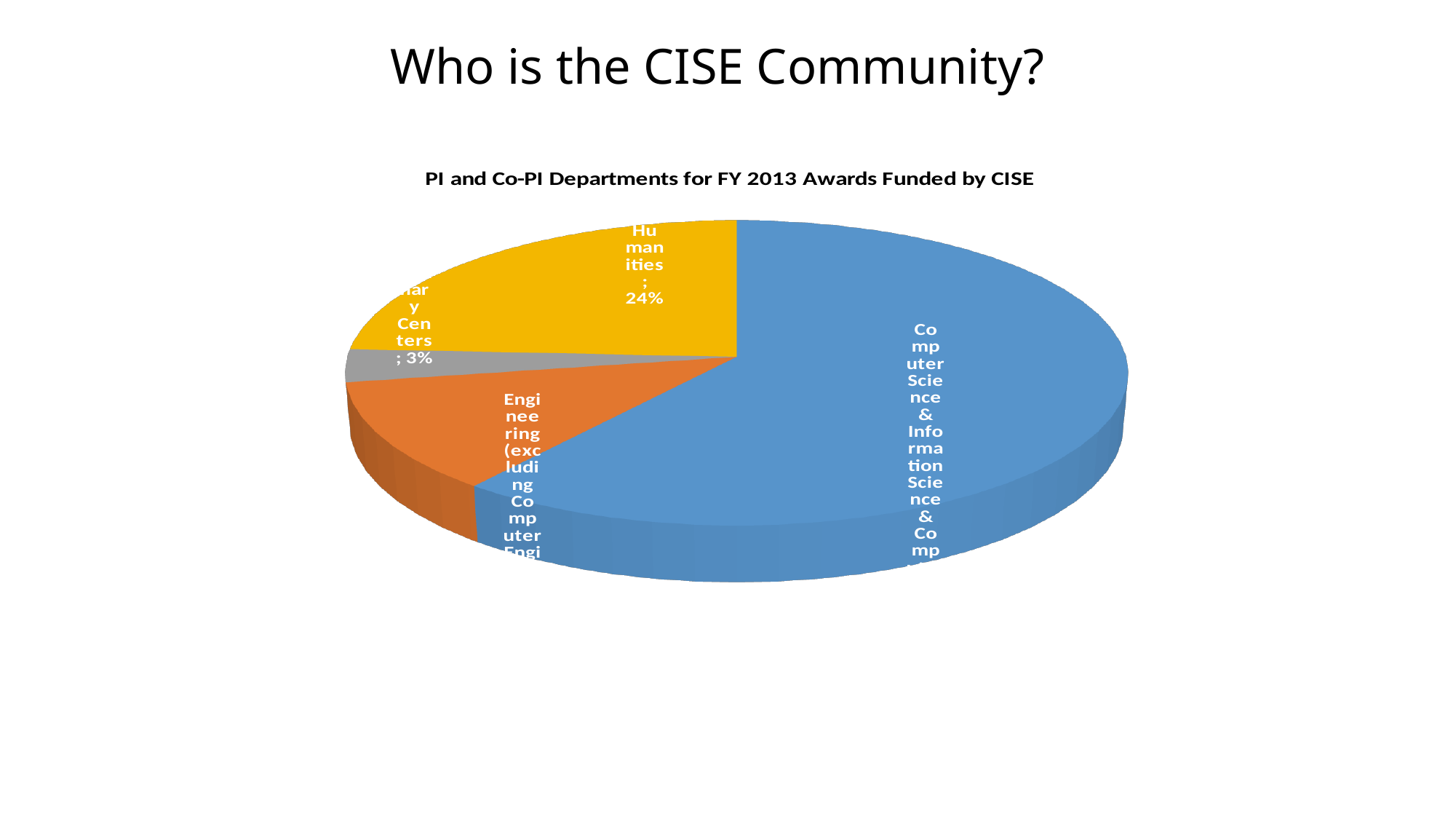
How many slices does the pie chart have? 4 What share of the pie does Humanities represent? 24% Is the share of the blue slice (Computer Science & Information Science) greater or less than 50%? greater What is the title of the chart? PI and Co-PI Departments for FY 2013 Awards Funded by CISE Is the share of the Engineering (excluding Computer Engineering) slice greater or less than 50%? less What is the difference in percentage points between the Humanities slice (24%) and the Centers slice (3%)? 21% What colour is the Humanities slice? yellow Which slice is larger, Humanities or Engineering (excluding Computer Engineering)? Humanities What percentage is shown for the smallest slice of the pie? 3% What kind of chart is shown on the slide? pie chart